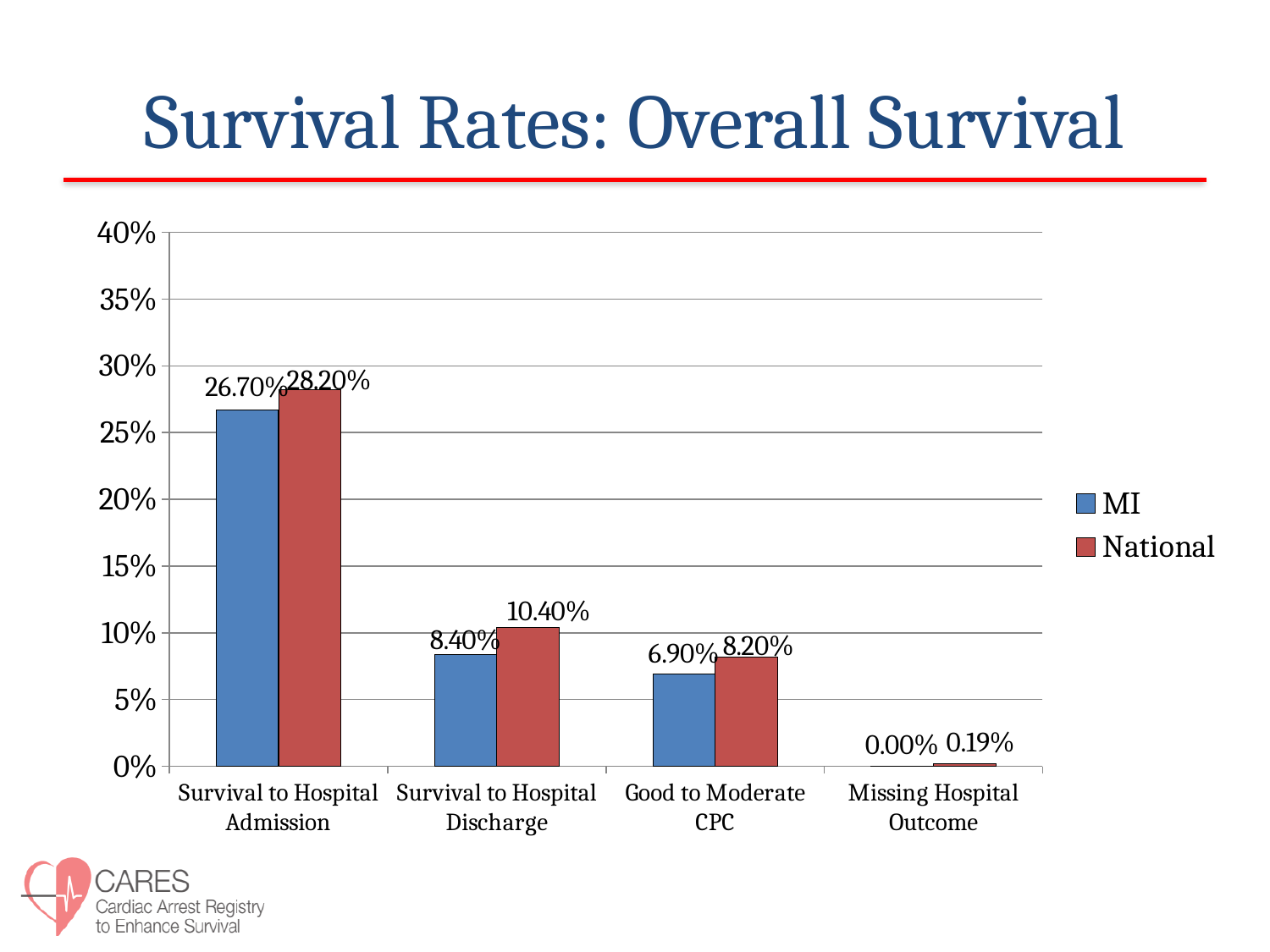
What is the MI value for Good to Moderate CPC? 6.90% What is the MI value for Survival to Hospital Admission? 26.70% Which is larger for Good to Moderate CPC, the MI value or the National value? National Which category has the highest National value? Survival to Hospital Admission What is the difference between the National and MI values for Survival to Hospital Discharge? 2.00% What is the National value for Survival to Hospital Discharge? 10.40% What kind of chart is shown on the slide? Bar chart Which category has the lowest MI value? Missing Hospital Outcome What is the National value for Missing Hospital Outcome? 0.19% Is the MI value for Survival to Hospital Admission greater or less than 25%? greater How many categories are shown on the x axis? 4 How many series does the legend list? 2